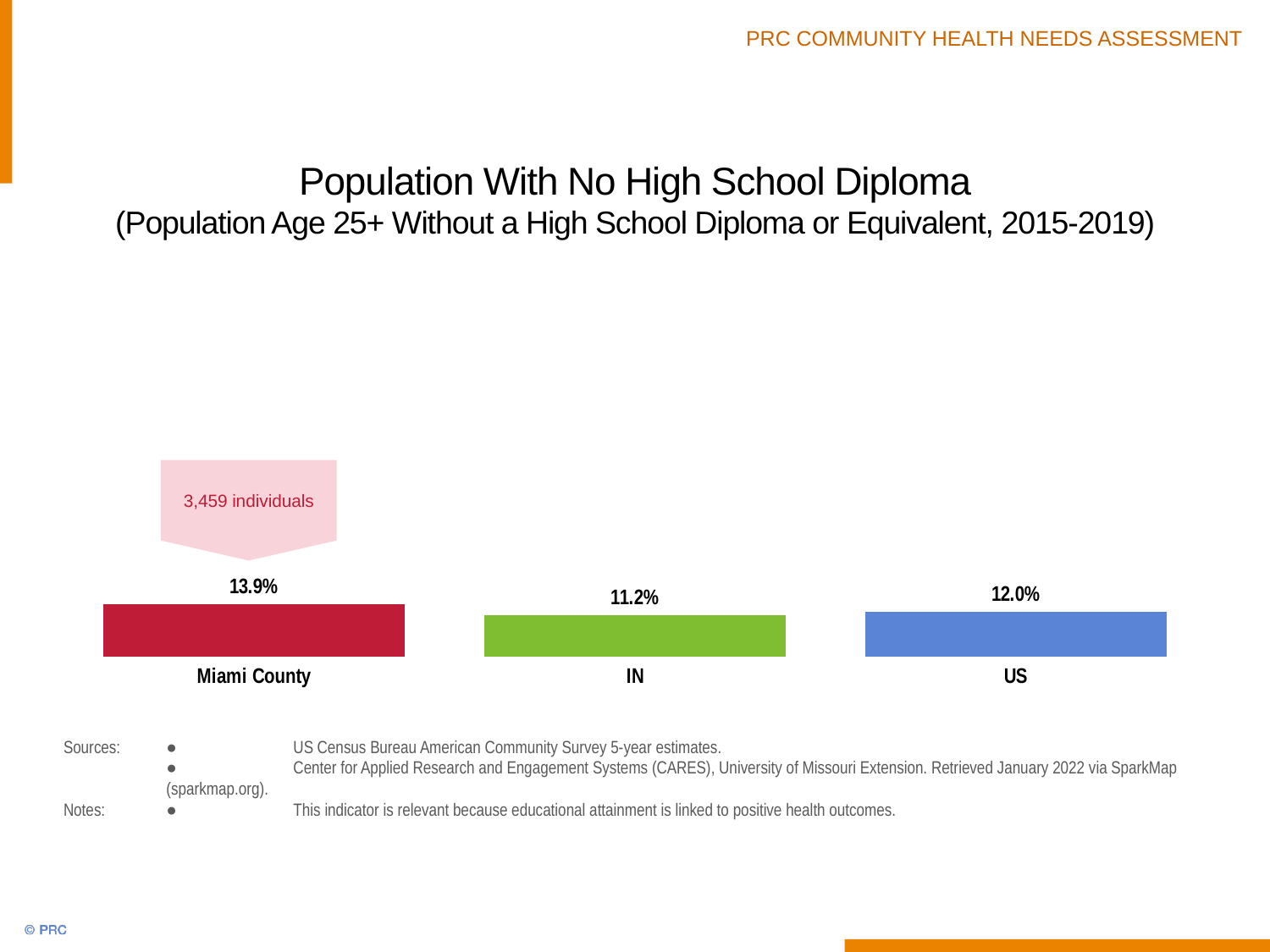
What is the value for Miami County? 13.9% Which category has the lowest value? IN What is the difference between the values for US and IN? 0.8% What kind of chart is shown on the slide? Bar chart What is the title of the chart? Population With No High School Diploma What is the difference between the values for Miami County and IN? 2.7% What is the value for US? 12.0% How many categories are shown in the chart? 3 How many individuals does the callout above the Miami County bar report? 3,459 individuals What is the value for IN? 11.2% Which category has the highest value? Miami County Which is larger, the value for Miami County or the value for US? Miami County